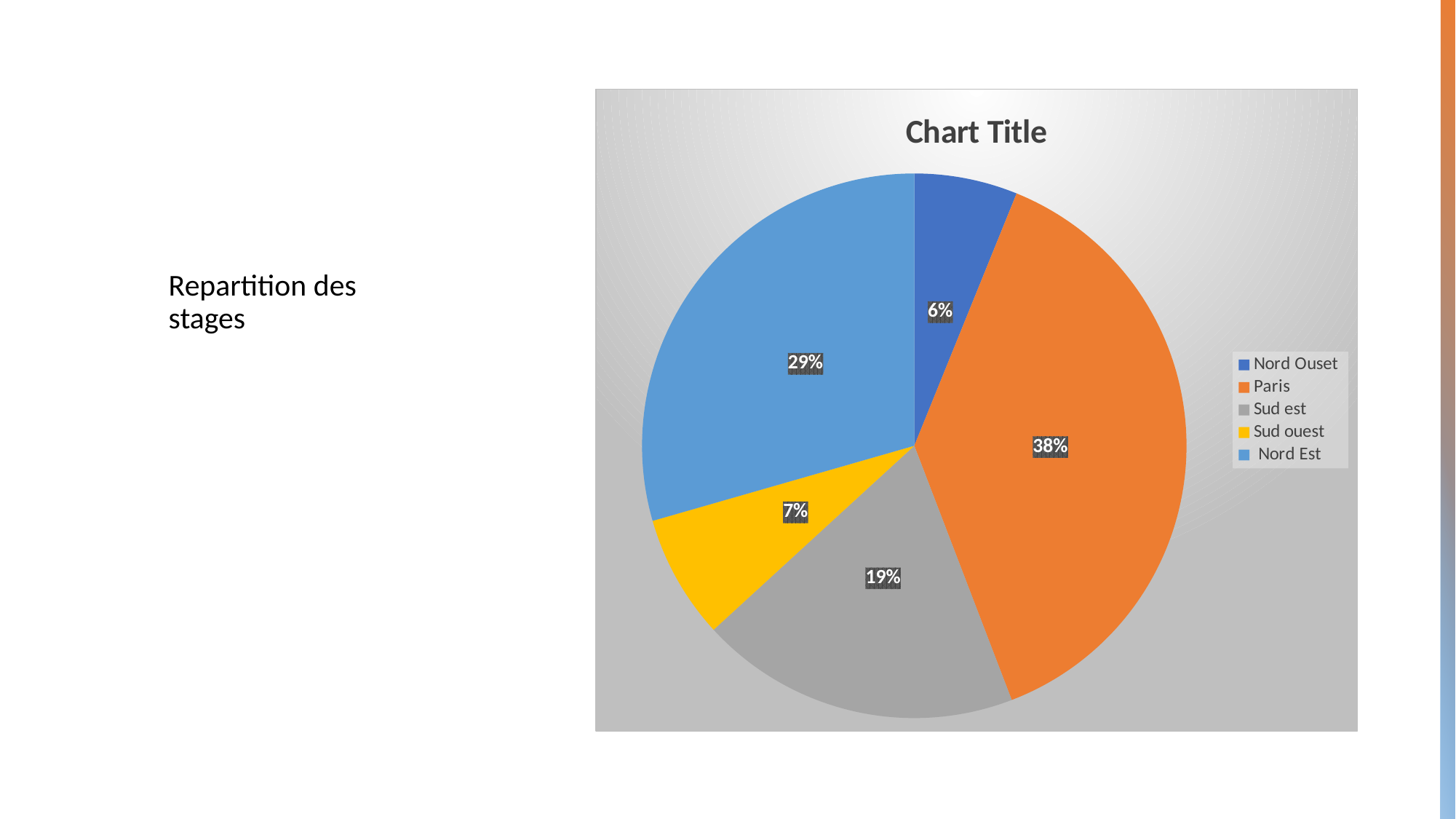
Which is larger, the share for Sud est or the share for Sud ouest? Sud est What percentage of the pie does Paris represent? 38% What percentage of the pie does Sud est represent? 19% How many categories does the legend list? 5 What percentage of the pie does Nord Est represent? 29% Which category has the smallest slice of the pie? Nord Ouset What kind of chart is shown on the slide? pie chart What is the difference in percentage points between Paris and Nord Est? 9 Which category has the largest slice of the pie? Paris What percentage of the pie does Sud ouest represent? 7% What is the title of the chart? Chart Title What percentage of the pie does Nord Ouset represent? 6%